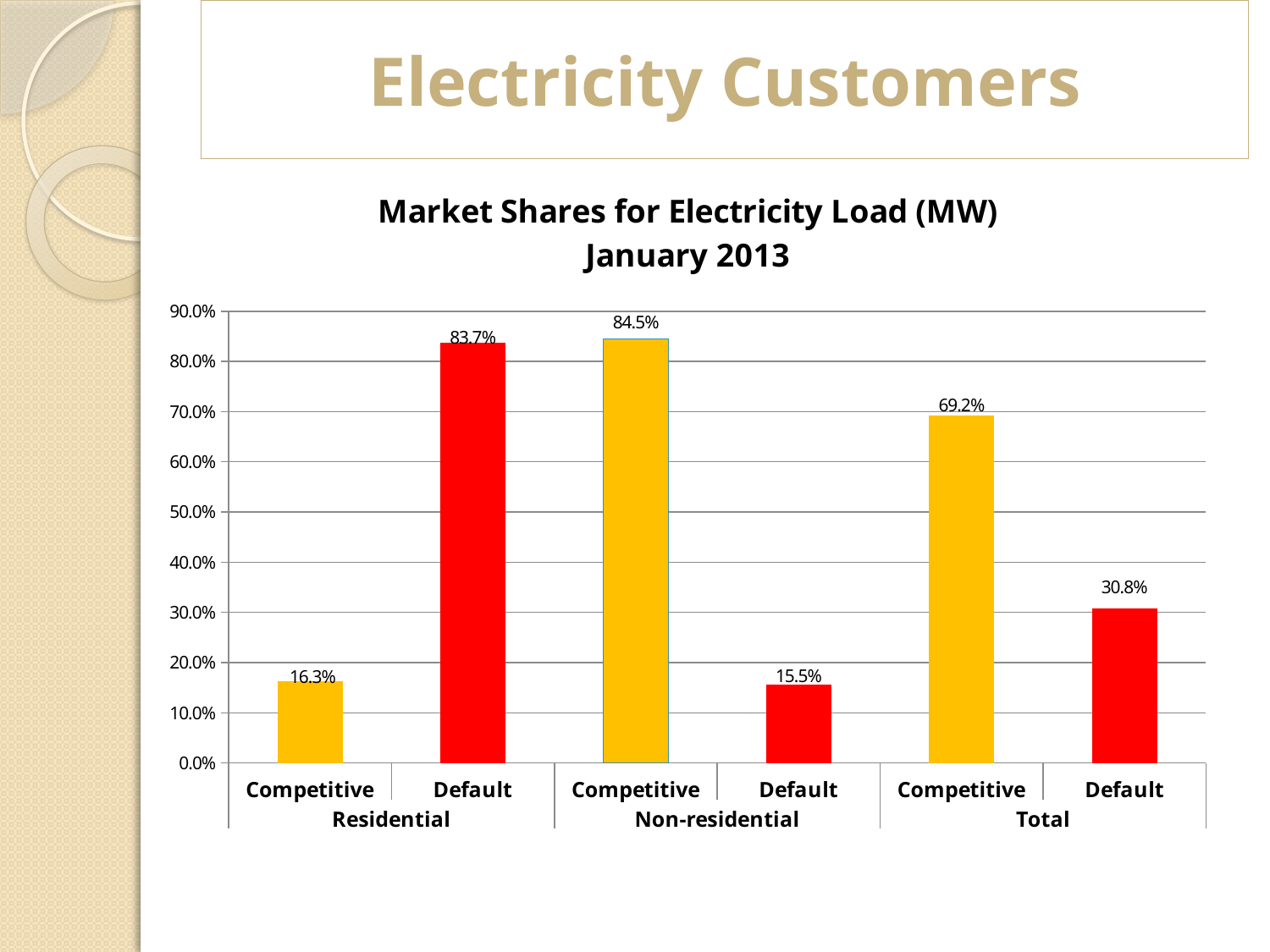
Which bar has the highest value? Non-residential Competitive Which is larger, Residential Default or Total Competitive? Residential Default Is the value for Total Default greater or less than 40.0%? less What is the difference between Total Competitive and Total Default? 38.4% What kind of chart is shown? Bar chart What is the market share for Residential Competitive? 16.3% What is the market share for Total Competitive? 69.2% What is the difference between Residential Default and Residential Competitive? 67.4% What is the title of the chart? Market Shares for Electricity Load (MW) January 2013 What is the market share for Non-residential Default? 15.5% How many bars are plotted in the chart? 6 Which bar has the lowest value? Non-residential Default